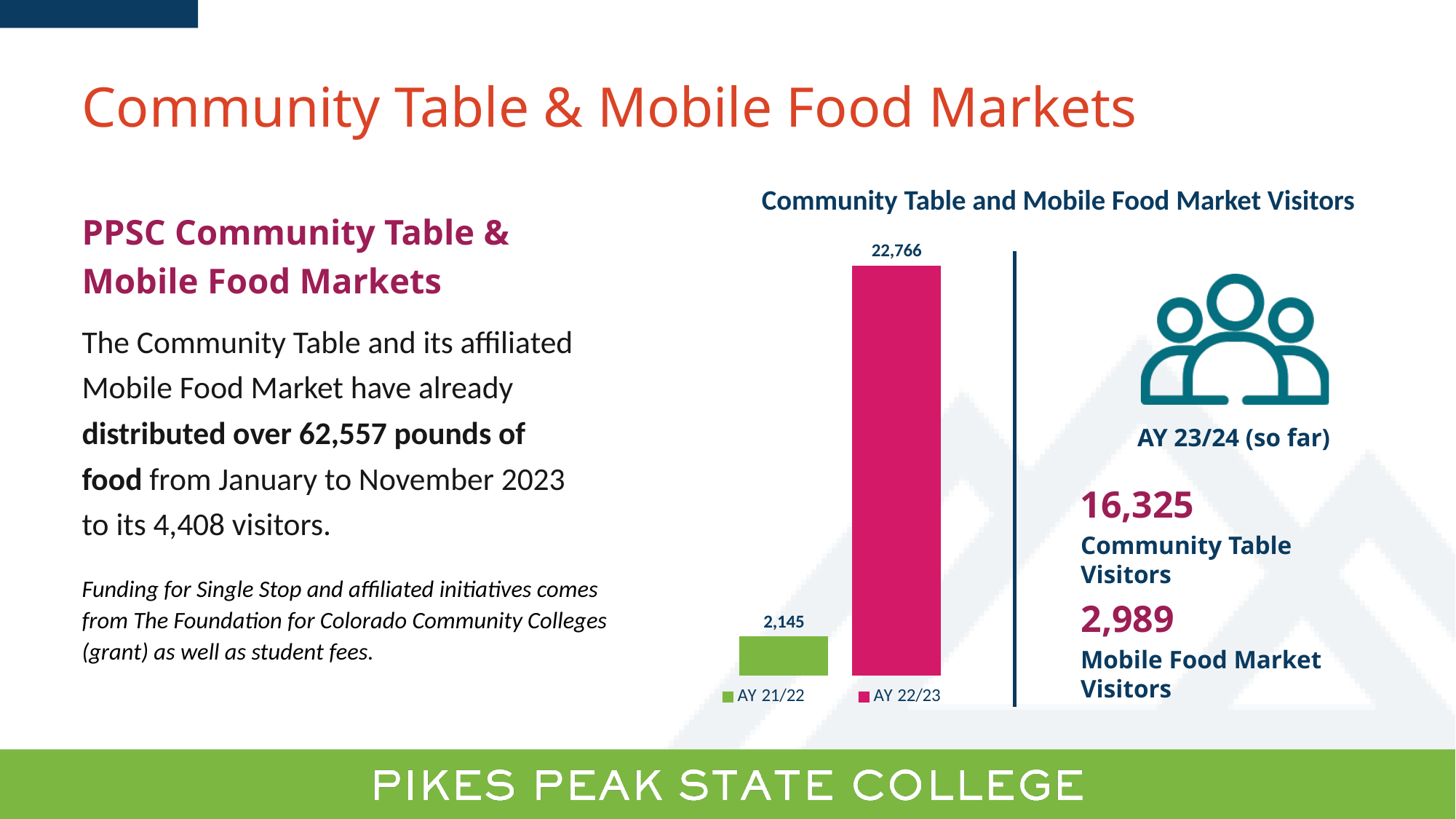
What is the title of the chart on the slide? Community Table and Mobile Food Market Visitors What is the difference in visitors between AY 22/23 and AY 21/22? 20,621 What is the value for AY 21/22 in the Community Table and Mobile Food Market Visitors chart? 2,145 What colour is the bar for AY 21/22 in the chart? Green Which is larger, the visitors for AY 21/22 or AY 22/23? AY 22/23 Which academic year has the highest number of visitors in the chart? AY 22/23 What is the value for AY 22/23 in the Community Table and Mobile Food Market Visitors chart? 22,766 Do the visitor numbers rise or fall from AY 21/22 to AY 22/23? Rise How many bars are plotted in the Community Table and Mobile Food Market Visitors chart? 2 Which academic year has the lowest number of visitors in the chart? AY 21/22 What kind of chart is shown on the slide? Bar chart How many entries does the legend of the chart list? 2